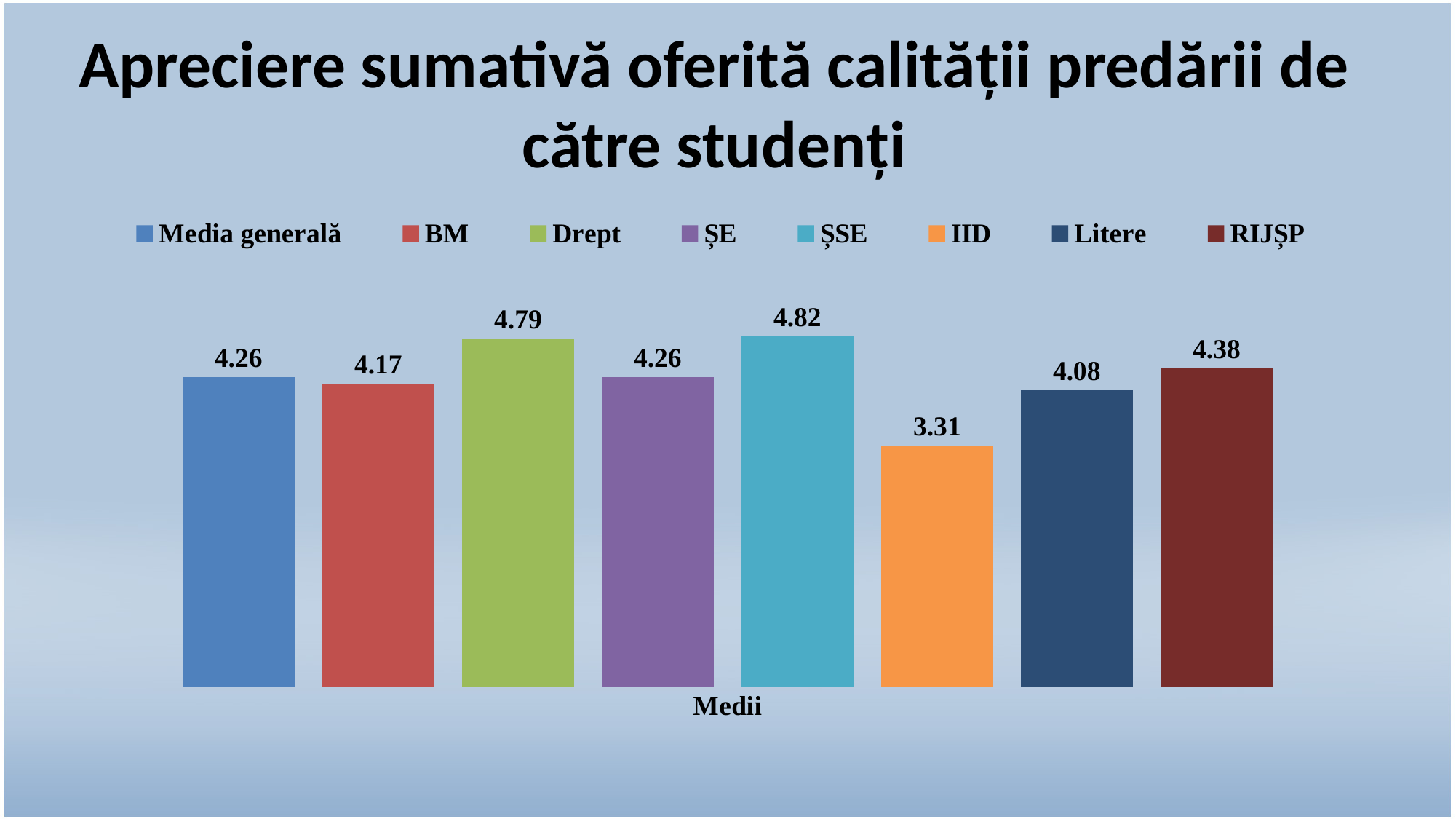
Which series has the lowest value? IID What kind of chart is shown on the slide? Bar chart Which series has the highest value? ȘSE What is the value for Drept? 4.79 What is the value for IID? 3.31 What is the value for RIJȘP? 4.38 Which is larger, the value for Litere or the value for RIJȘP? RIJȘP What is the label shown on the x axis? Medii How many series does the legend list? 8 What is the difference between the values for Drept and BM? 0.62 What is the difference between the values for ȘSE and IID? 1.51 What is the value for Media generală? 4.26